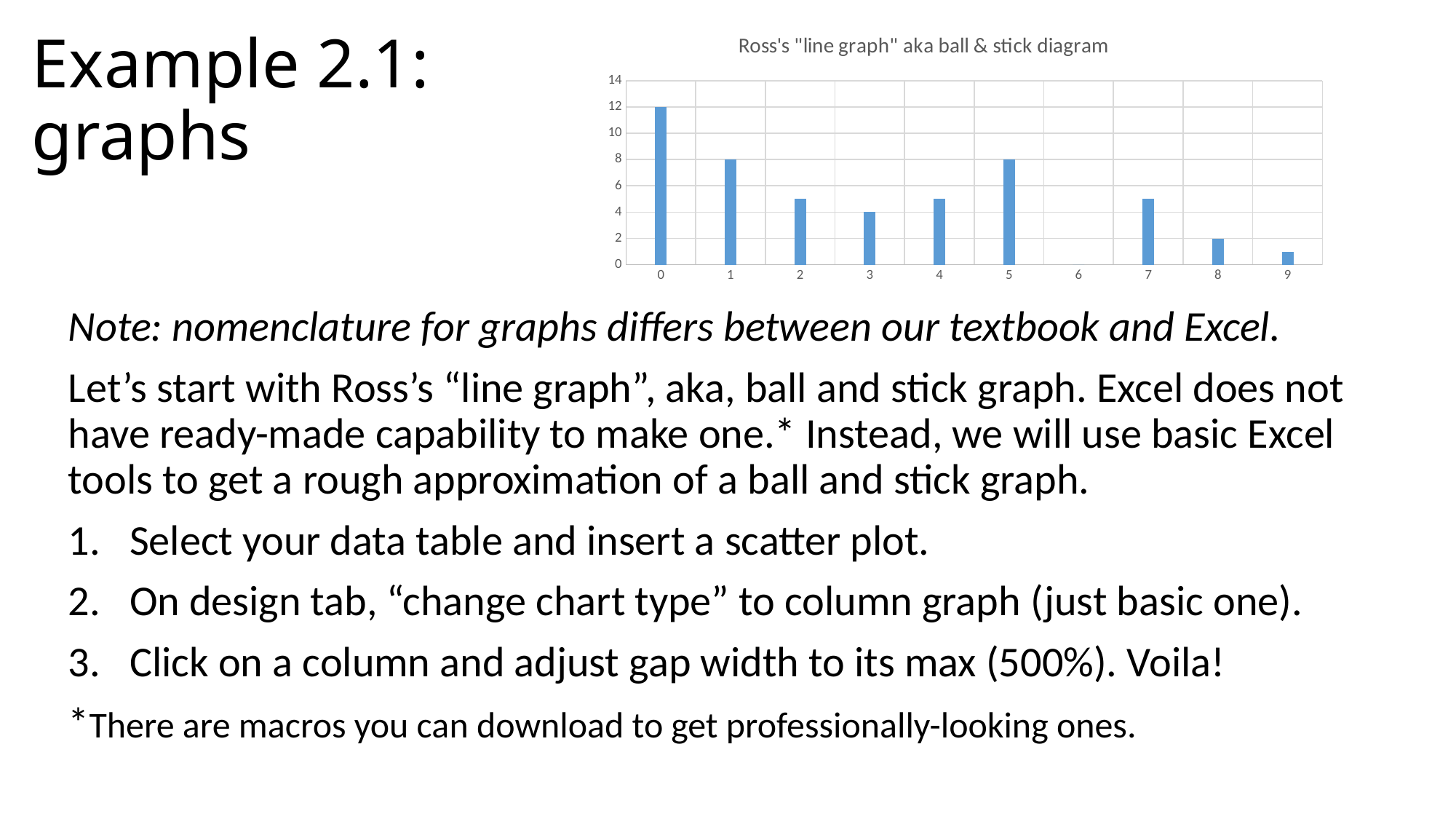
Which has the larger value, category 1 or category 3? 1 What is the value for category 3? 4 What is the value for category 8? 2 What is the difference between the values for category 5 and category 8? 6 What kind of chart is shown on the slide? bar chart What is the value for category 0? 12 Is the value for category 2 greater or less than 6? less What is the title of the chart? Ross's "line graph" aka ball & stick diagram Which category has the highest value? 0 How many categories are shown on the x axis? 10 What is the value for category 1? 8 What is the difference between the values for category 0 and category 1? 4